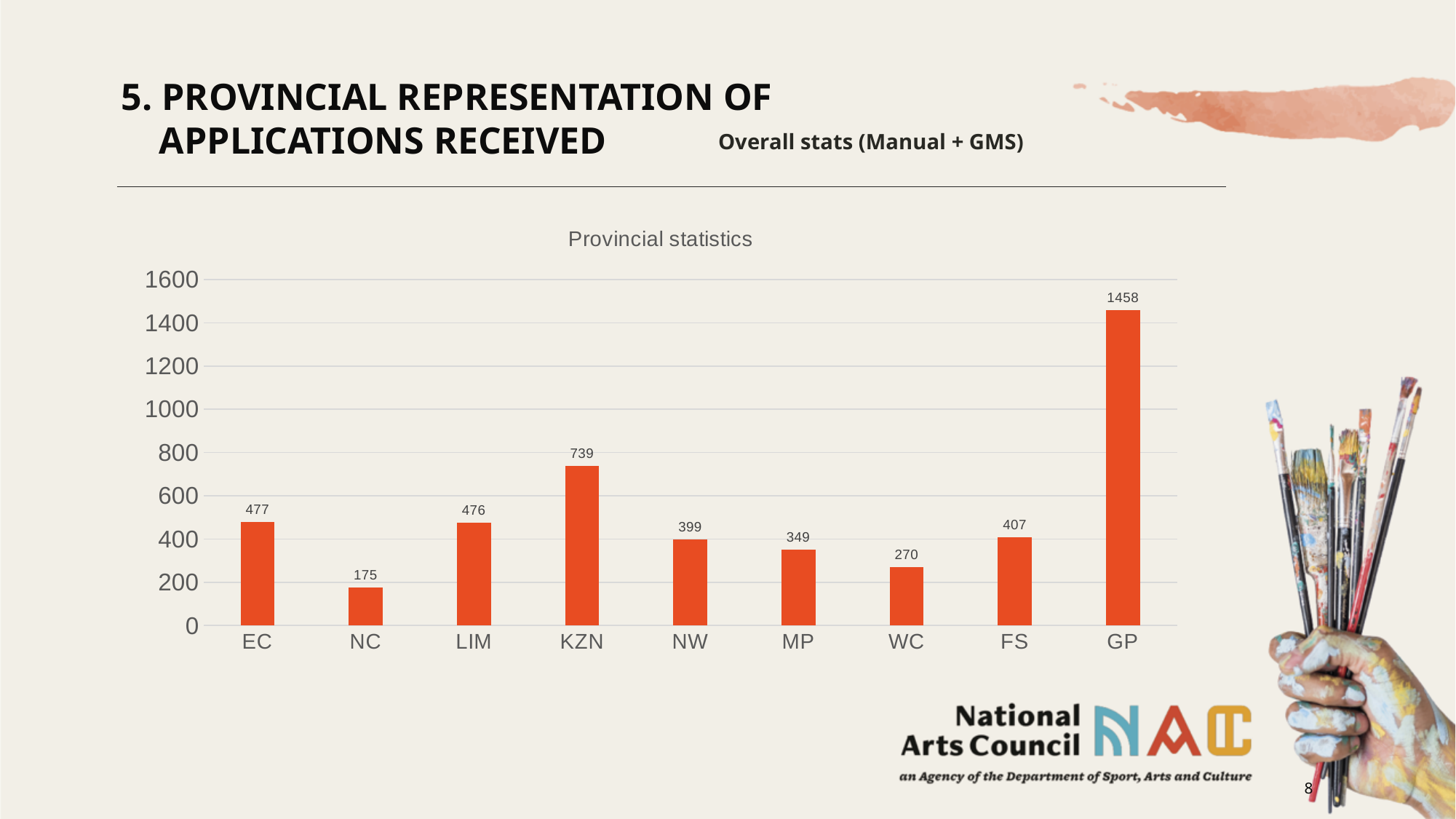
What is the difference between the values for EC and NC? 302 What is the title of the chart? Provincial statistics Which province has the lowest value? NC What kind of chart is shown on the slide? Bar chart What is the value for KZN? 739 What is the difference between the values for GP and KZN? 719 How many provinces are shown on the x axis? 9 What is the value for NC? 175 Which is larger, the value for NW or the value for MP? NW Which province has the highest value? GP What is the value for WC? 270 What is the value for GP? 1458